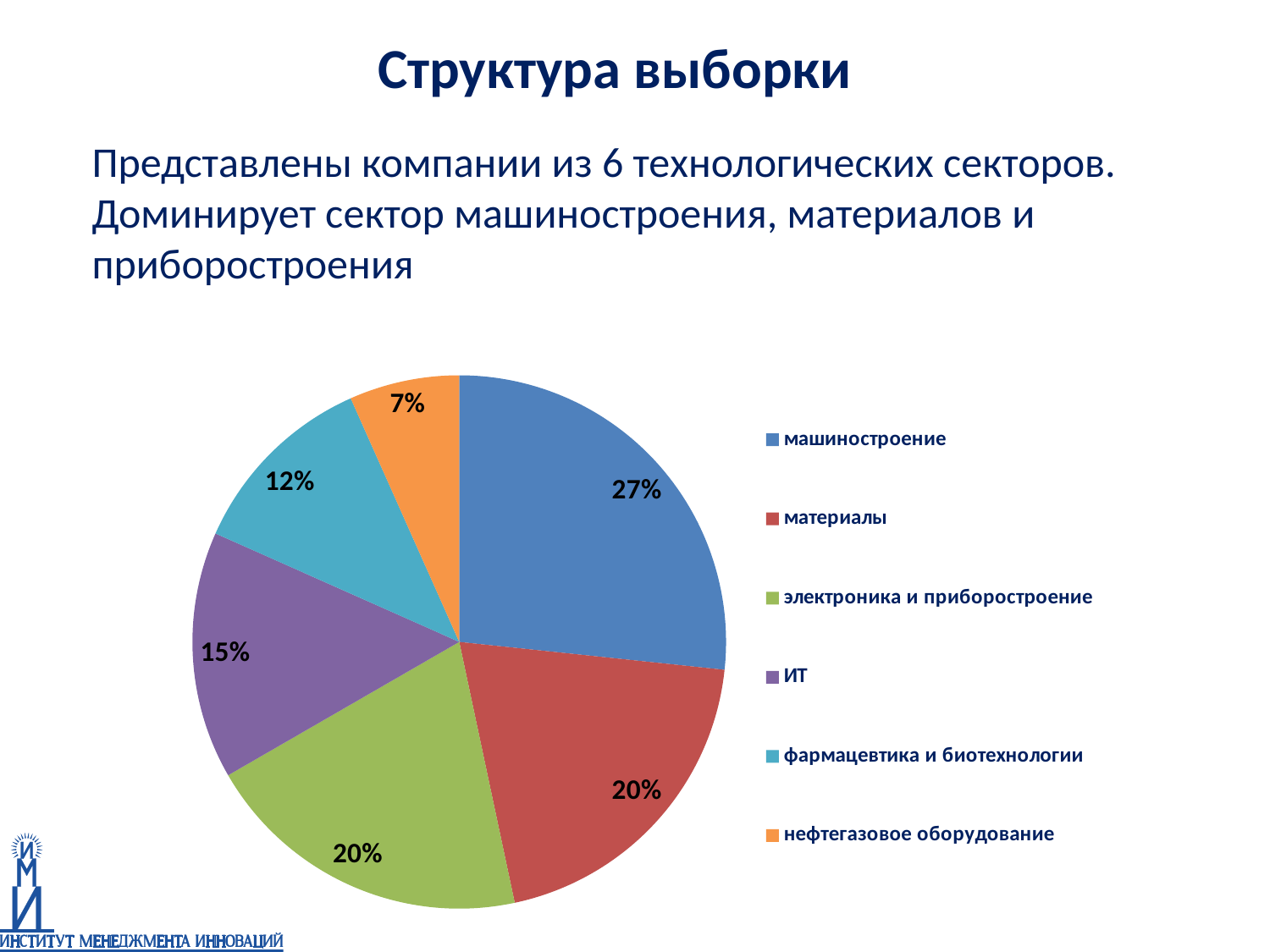
What is the combined share of материалы and электроника и приборостроение? 40% Which is larger, the share of ИТ or the share of фармацевтика и биотехнологии? ИТ What share of the pie does ИТ have? 15% How many sectors are shown in the pie chart? 6 Which sector has the largest slice of the pie? машиностроение What share of the pie does машиностроение have? 27% What kind of chart is shown on the slide? pie chart What share of the pie does фармацевтика и биотехнологии have? 12% What colour is the slice for нефтегазовое оборудование? orange What is the difference between the shares of машиностроение and ИТ? 12% What share of the pie does нефтегазовое оборудование have? 7% Which sector has the smallest slice of the pie? нефтегазовое оборудование